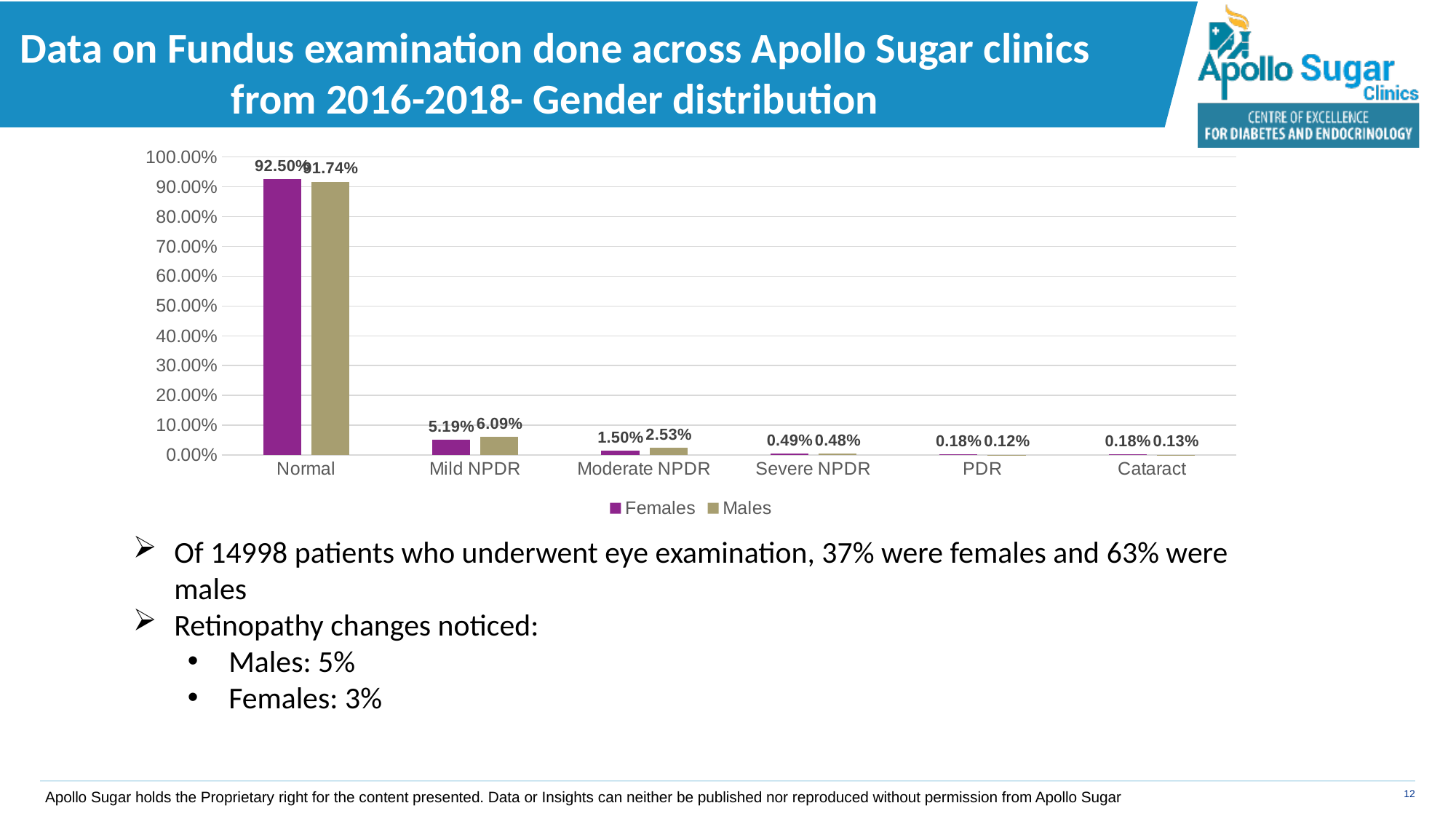
What kind of chart is shown on the slide? Bar chart What is the value for Males in the Mild NPDR category? 6.09% How many series does the legend list? 2 What is the value for Males in the Cataract category? 0.13% How many categories are shown on the x axis? 6 What is the difference between the Females and Males values for Normal? 0.76% Is the value for Females in the Normal category greater or less than 90.00%? greater What is the value for Females in the Moderate NPDR category? 1.50% What is the value for Females in the Normal category? 92.50% Which category has the highest value for Males? Normal What is the difference between the Males and Females values for Mild NPDR? 0.90% Which is larger for Moderate NPDR, the Females value or the Males value? Males